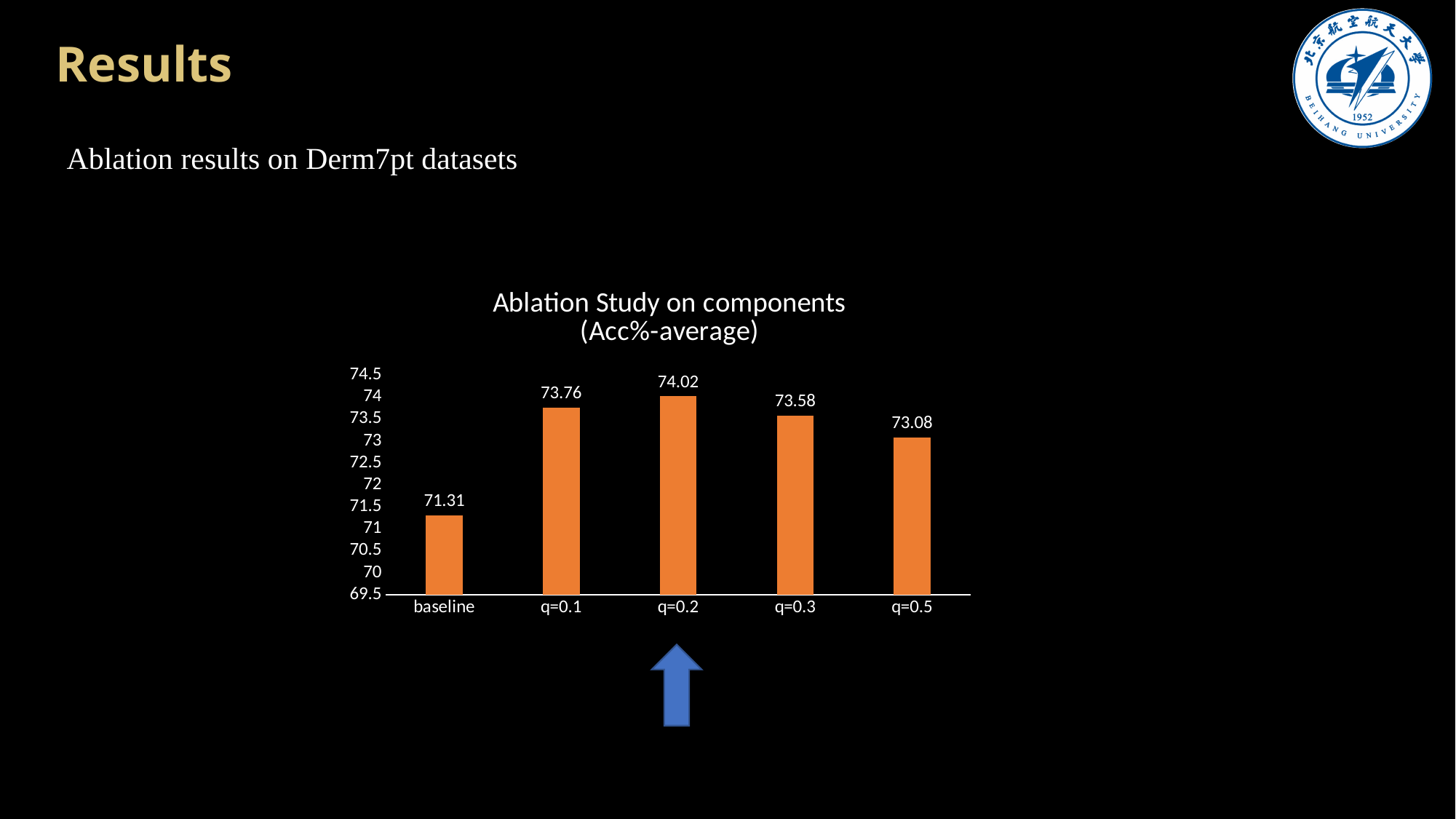
What is the value for q=0.5? 73.08 What is the title of the chart? Ablation Study on components (Acc%-average) Which category has the highest value? q=0.2 What kind of chart is shown on the slide? bar chart What is the value for baseline? 71.31 What is the difference between the values for q=0.1 and q=0.3? 0.18 What is the difference between the values for q=0.2 and baseline? 2.71 Which is larger, the value for q=0.1 or the value for q=0.5? q=0.1 What is the value for q=0.2? 74.02 How many categories are shown on the x axis? 5 Which category has the lowest value? baseline Is the value for q=0.3 greater or less than 73? greater